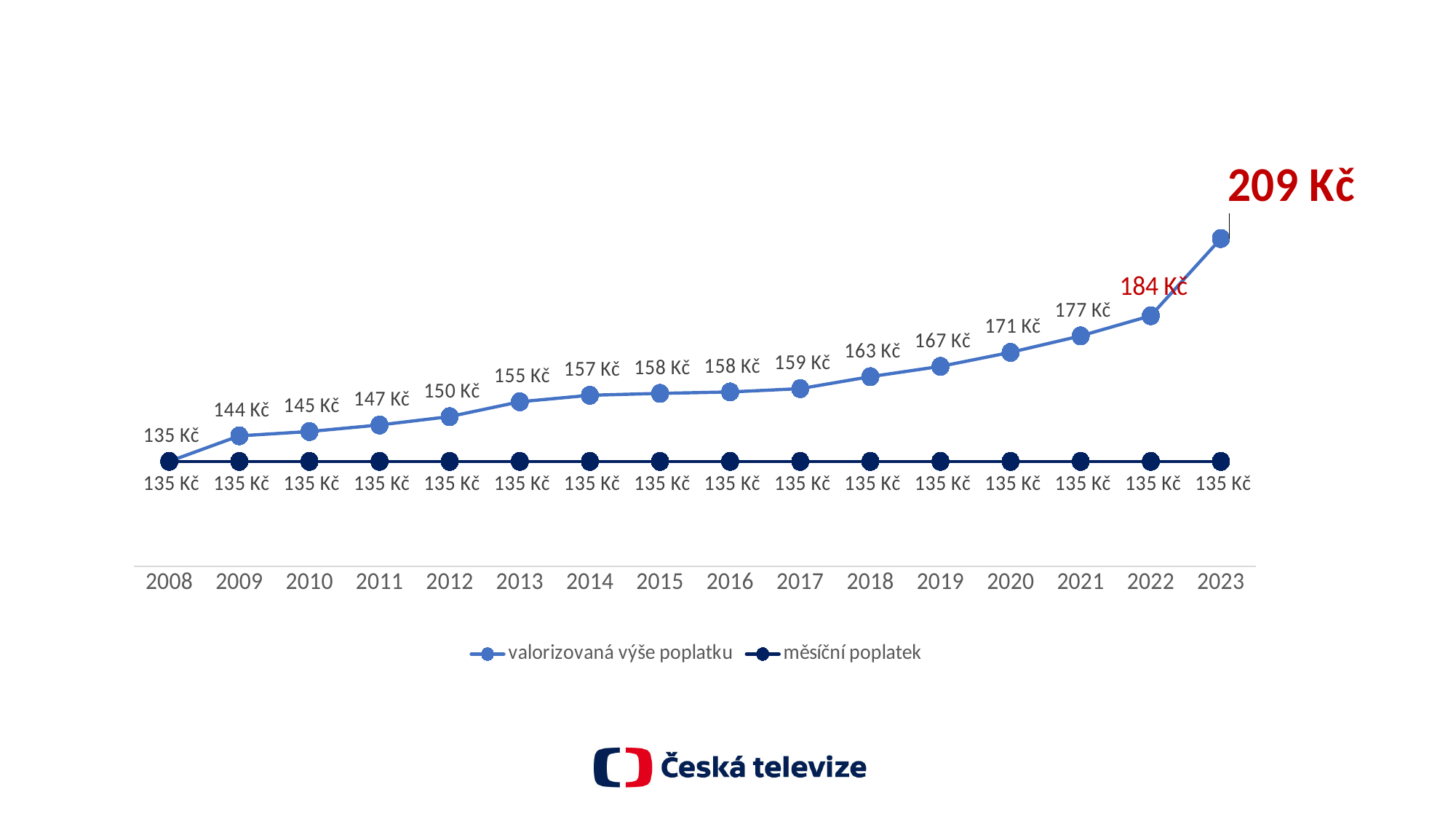
What is the value of 'valorizovaná výše poplatku' in 2022? 184 Kč Does 'valorizovaná výše poplatku' rise or fall from 2008 to 2023? rise What kind of chart is this? line chart How many series does the legend list? 2 In which year is 'valorizovaná výše poplatku' highest? 2023 What is the difference between 'valorizovaná výše poplatku' and 'měsíční poplatek' in 2023? 74 Kč Which is larger in 2020: 'valorizovaná výše poplatku' or 'měsíční poplatek'? valorizovaná výše poplatku What is the value of 'valorizovaná výše poplatku' in 2013? 155 Kč How many years are shown on the x axis? 16 What is the value of 'valorizovaná výše poplatku' in 2023? 209 Kč In which year is 'valorizovaná výše poplatku' lowest? 2008 What is the value of 'měsíční poplatek' in 2015? 135 Kč